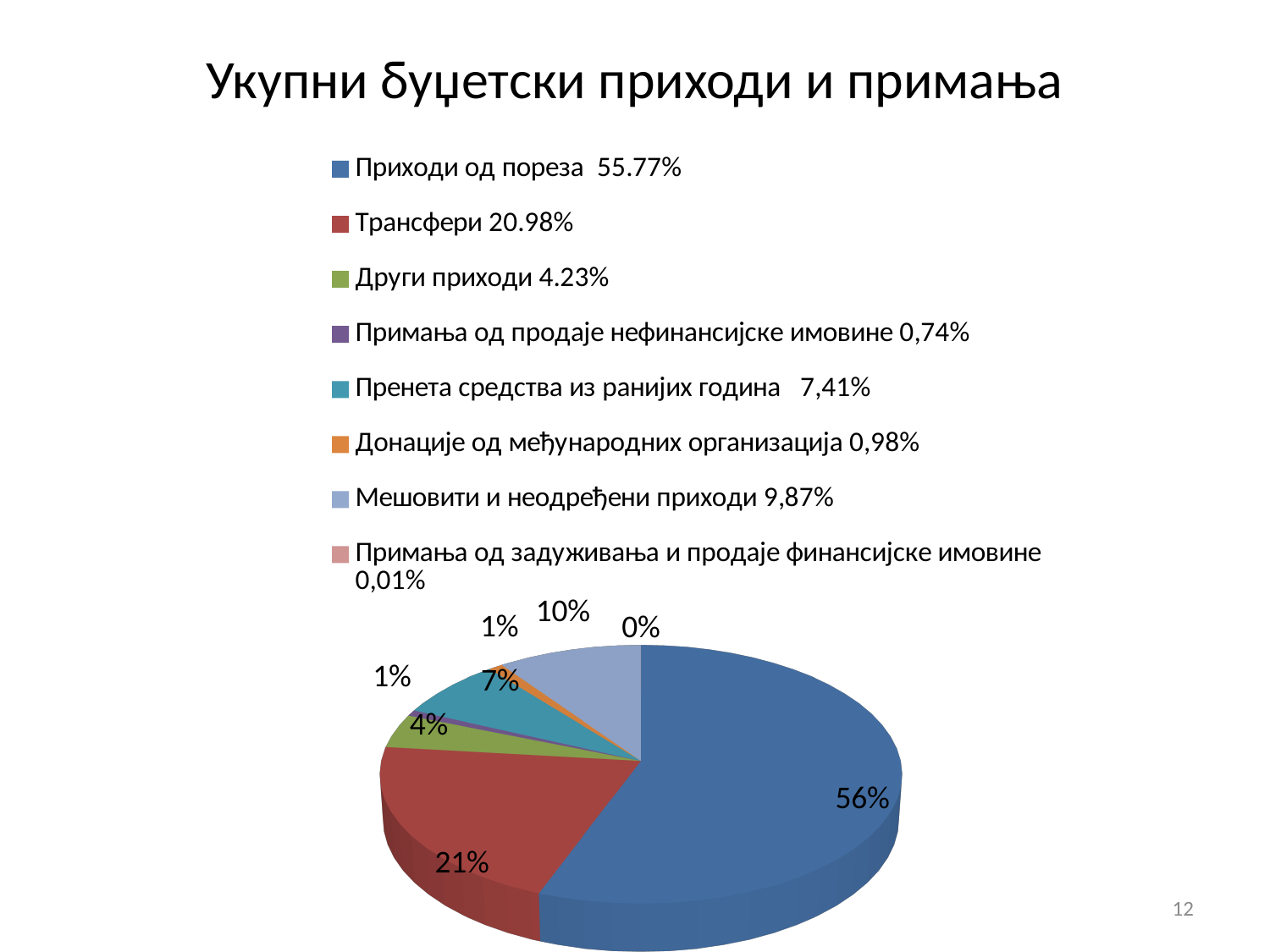
According to the legend, what share does Донације од међународних организација have? 0,98% What data label is shown on the slice for Мешовити и неодређени приходи? 10% Which is larger, the slice for Трансфери or the slice for Мешовити и неодређени приходи? Трансфери Which category has the smallest share of the pie? Примања од задуживања и продаје финансијске имовине What data label is shown on the slice for Трансфери? 21% Which category has the largest share of the pie? Приходи од пореза What data label is shown on the slice for Пренета средства из ранијих година? 7% What data label is shown on the slice for Други приходи? 4% According to the legend, what share does Приходи од пореза have? 55.77% How many slices does the pie chart have? 8 What is the title of the slide's chart? Укупни буџетски приходи и примања What kind of chart is shown on the slide? pie chart